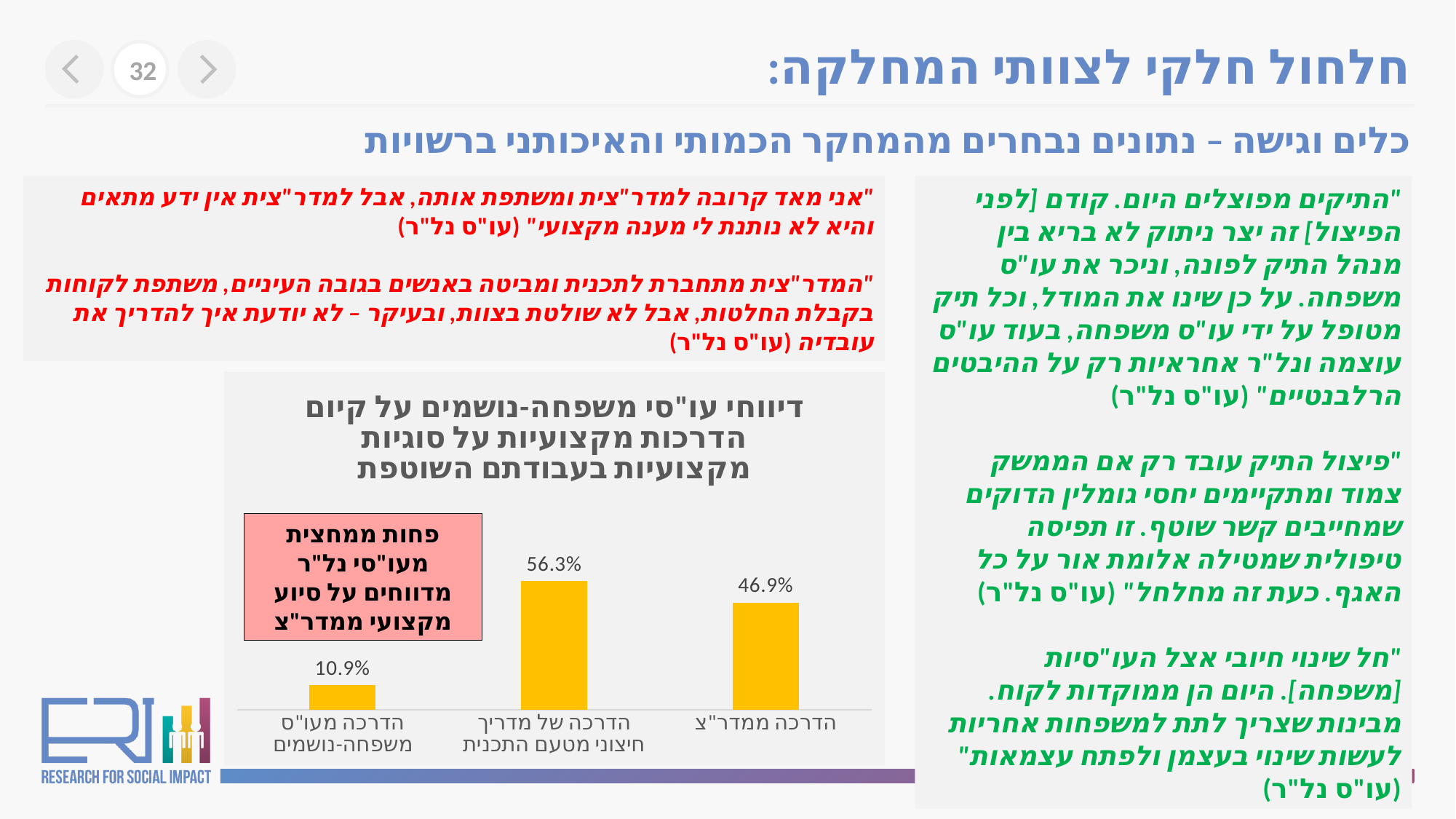
What value is shown for the bar labelled הדרכה ממדר"צ? 46.9% How many categories (bars) does the chart show? 3 What kind of chart is shown on the slide? Bar chart What colour are the bars in the chart? Yellow Which category has the lowest value in the chart? הדרכה מעו"ס משפחה-נושמים Which is larger: the value for הדרכה ממדר"צ or the value for הדרכה מעו"ס משפחה-נושמים? הדרכה ממדר"צ What is the difference between the values for הדרכה של מדריך חיצוני מטעם התכנית and הדרכה ממדר"צ? 9.4% What is the title of the chart? דיווחי עו"סי משפחה-נושמים על קיום הדרכות מקצועיות על סוגיות מקצועיות בעבודתם השוטפת What value is shown for the bar labelled הדרכה מעו"ס משפחה-נושמים? 10.9% Which category has the highest value in the chart? הדרכה של מדריך חיצוני מטעם התכנית What is the difference between the values for הדרכה ממדר"צ and הדרכה מעו"ס משפחה-נושמים? 36.0% What value is shown for the bar labelled הדרכה של מדריך חיצוני מטעם התכנית? 56.3%